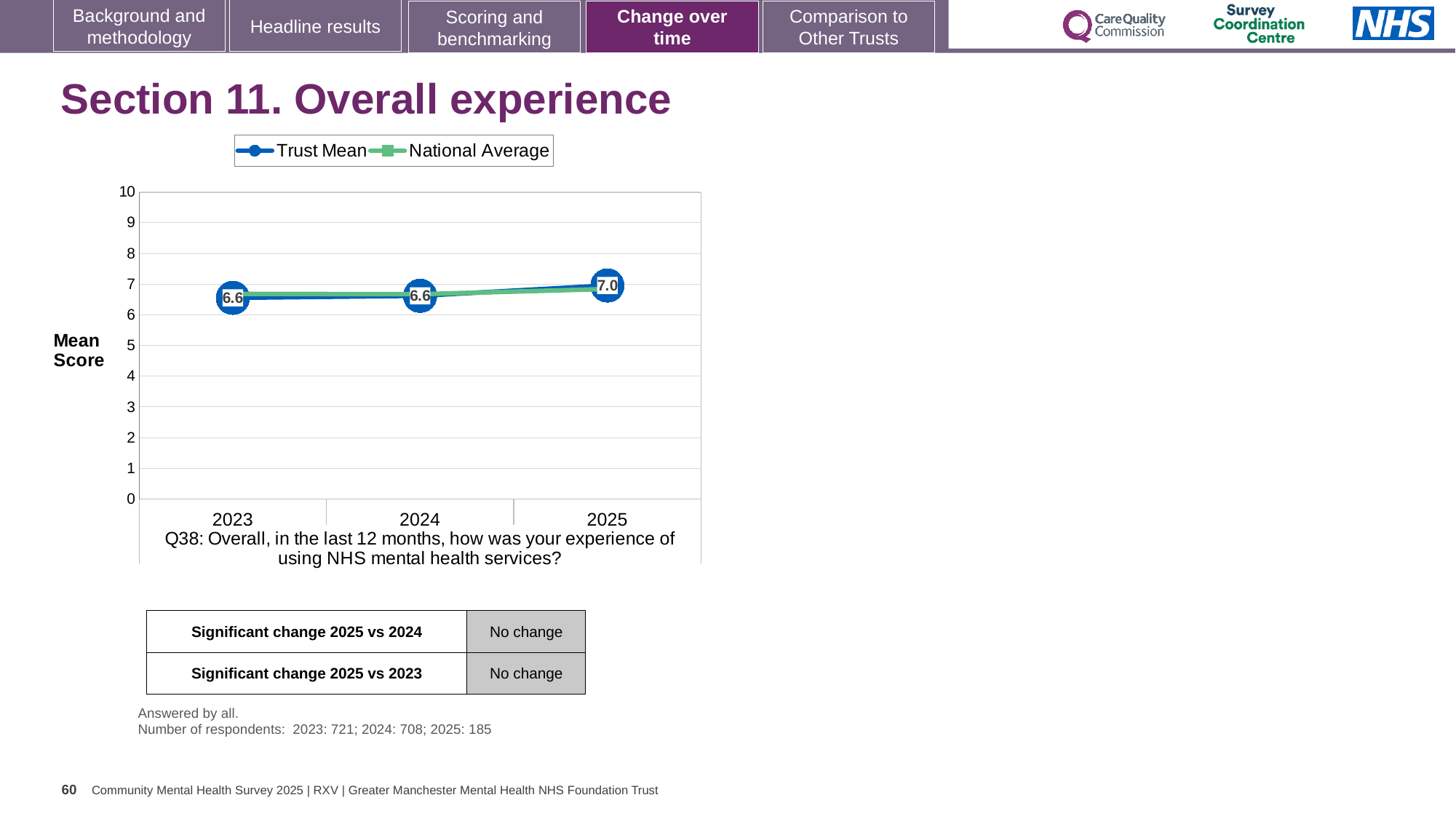
Is the Trust Mean for 2025 larger or smaller than the Trust Mean for 2024? larger In which year is the Trust Mean highest? 2025 What kind of chart is shown on the slide? line chart How many years are plotted on the x axis? 3 Does the Trust Mean rise or fall from 2024 to 2025? rise Is the National Average value for 2023 greater or less than 8? less What is the Trust Mean value for 2023? 6.6 What is the Trust Mean value for 2025? 7.0 What is the difference between the Trust Mean in 2025 and in 2023? 0.4 How many series does the legend list? 2 What is the Trust Mean value for 2024? 6.6 Is the National Average value for 2025 greater or less than 5? greater